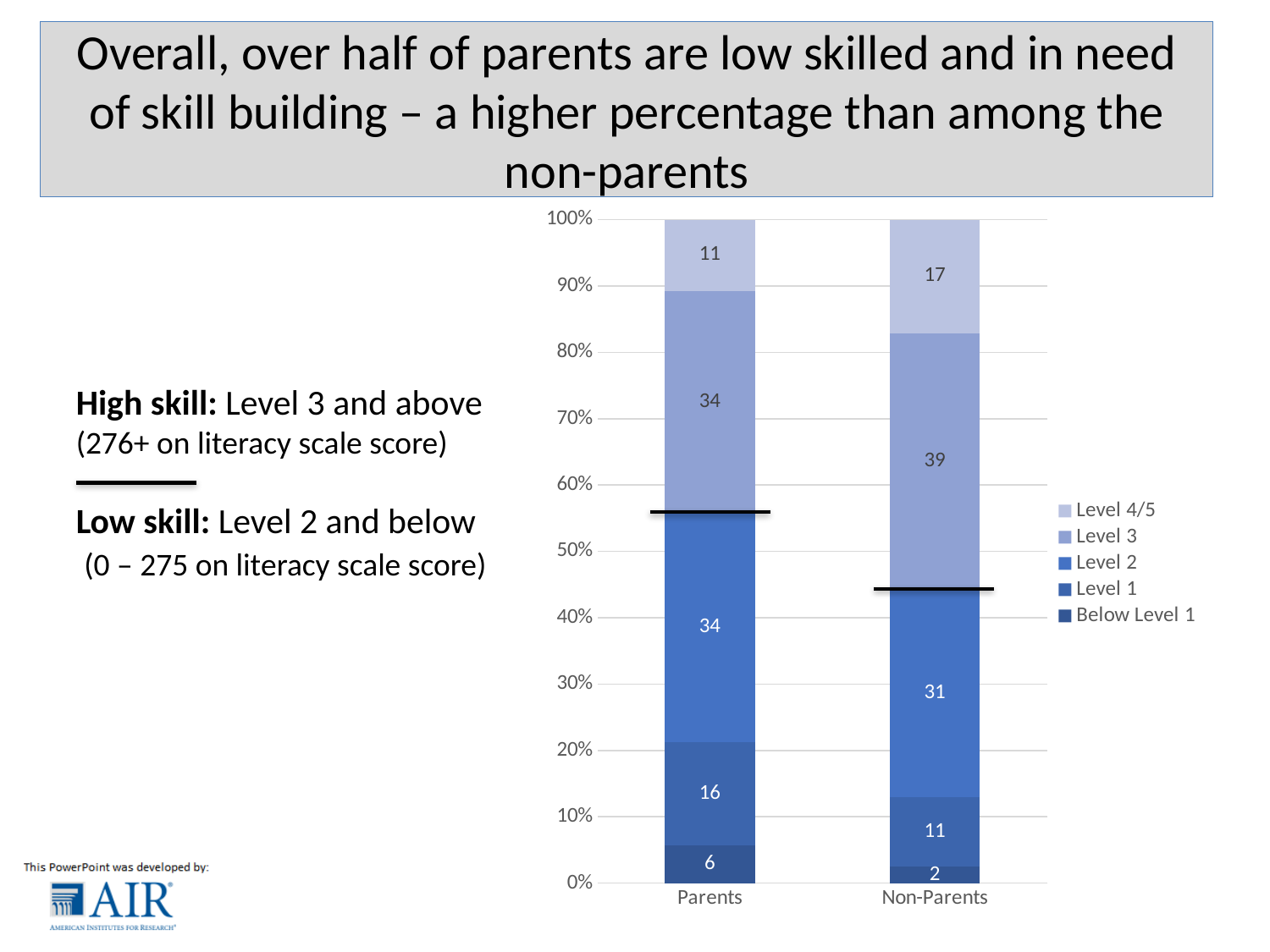
Which legend entry is listed first in the chart's legend? Level 4/5 What is the Below Level 1 value for Non-Parents? 2 How many categories are shown on the x axis of the chart? 2 What is the Level 4/5 value for Parents? 11 How many series does the chart's legend list? 5 What is the total of Below Level 1, Level 1 and Level 2 for Parents? 56 What is the Level 3 value for Non-Parents? 39 What is the Level 2 value for Parents? 34 Which category has the larger Below Level 1 value, Parents or Non-Parents? Parents What is the difference between the Level 1 value for Parents and the Level 1 value for Non-Parents? 5 What type of chart is shown on the slide? Stacked bar chart Which category has the larger Level 4/5 value, Parents or Non-Parents? Non-Parents